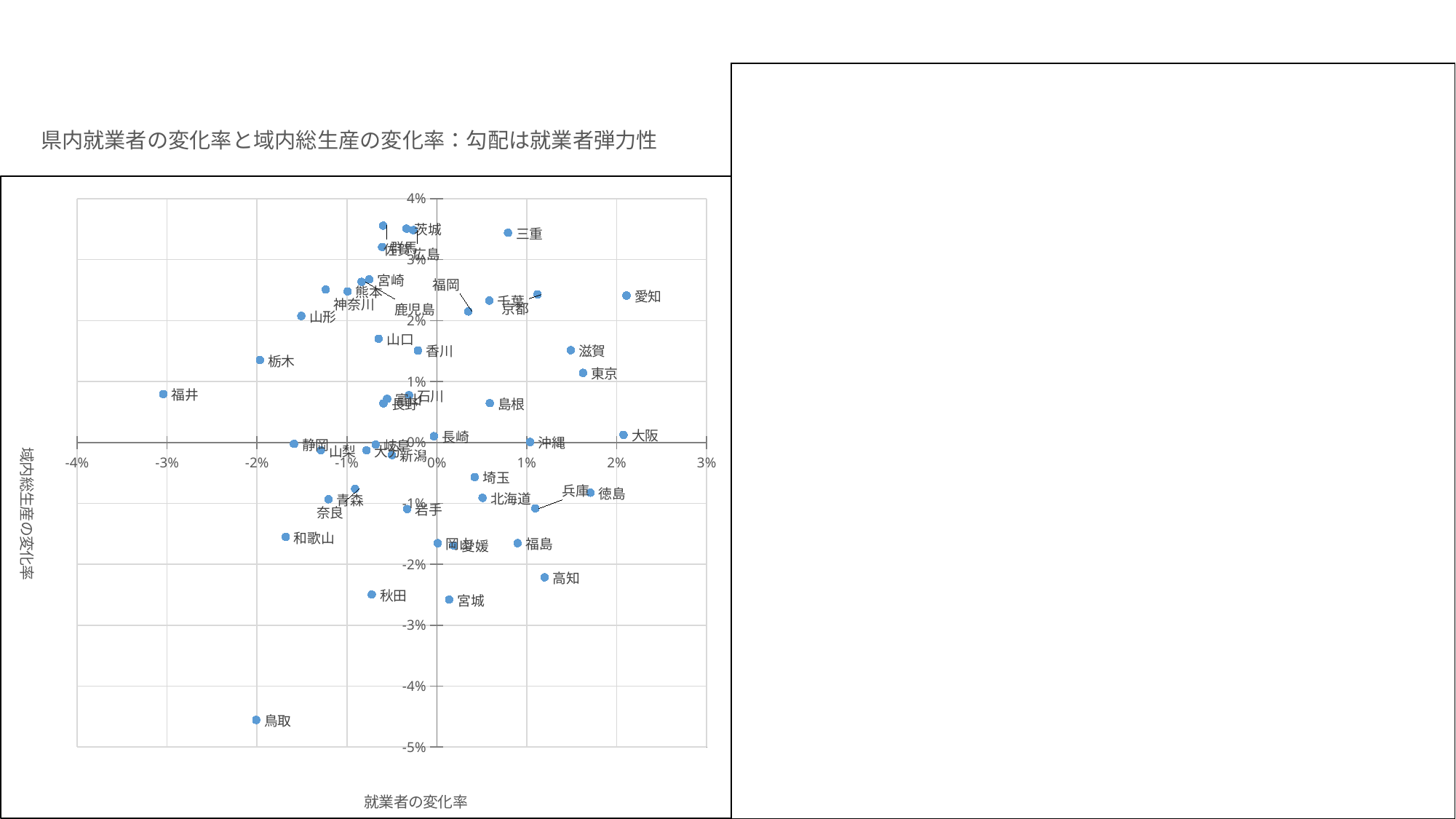
What kind of chart is shown on the slide? scatter chart Which has the higher vertical-axis value, 福井 or 鳥取? 福井 Which prefecture has the lowest value on the vertical axis (域内総生産の変化率)? 鳥取 Is the vertical-axis value for 三重 greater or less than 3%? greater Is the horizontal-axis value for 愛知 greater or less than 2%? greater What is the title of the chart? 県内就業者の変化率と域内総生産の変化率：勾配は就業者弾力性 Is the vertical-axis value for 秋田 greater or less than -2%? less Which has the larger horizontal-axis value, 愛知 or 福井? 愛知 What is the label of the horizontal axis? 就業者の変化率 Which prefecture has the lowest value on the horizontal axis (就業者の変化率)? 福井